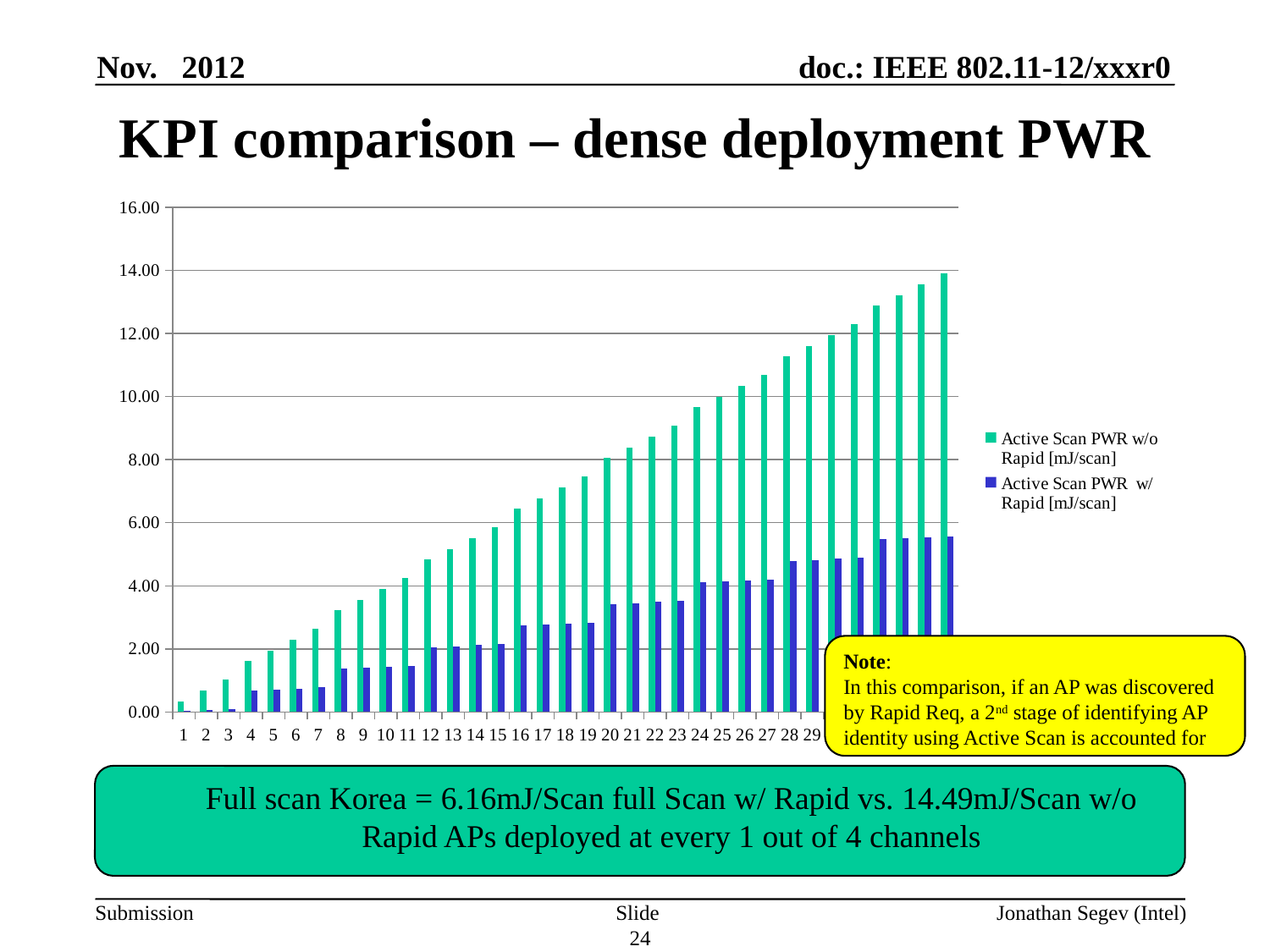
Is the value for Active Scan PWR w/o Rapid at category 29 greater or less than 10.00? greater Is the value for Active Scan PWR w/ Rapid at category 8 greater or less than 2.00? less How many series does the legend list? 2 At category 15, which series has the larger value: Active Scan PWR w/o Rapid or Active Scan PWR w/ Rapid? Active Scan PWR w/o Rapid [mJ/scan] What kind of chart is shown on the slide? bar chart Which series is shown in teal (green) bars? Active Scan PWR w/o Rapid [mJ/scan] Is the value for Active Scan PWR w/o Rapid at category 24 greater or less than 8.00? greater Do the values for Active Scan PWR w/o Rapid rise or fall as the category number increases along the x axis? rise Which series is shown in blue bars? Active Scan PWR w/ Rapid [mJ/scan]